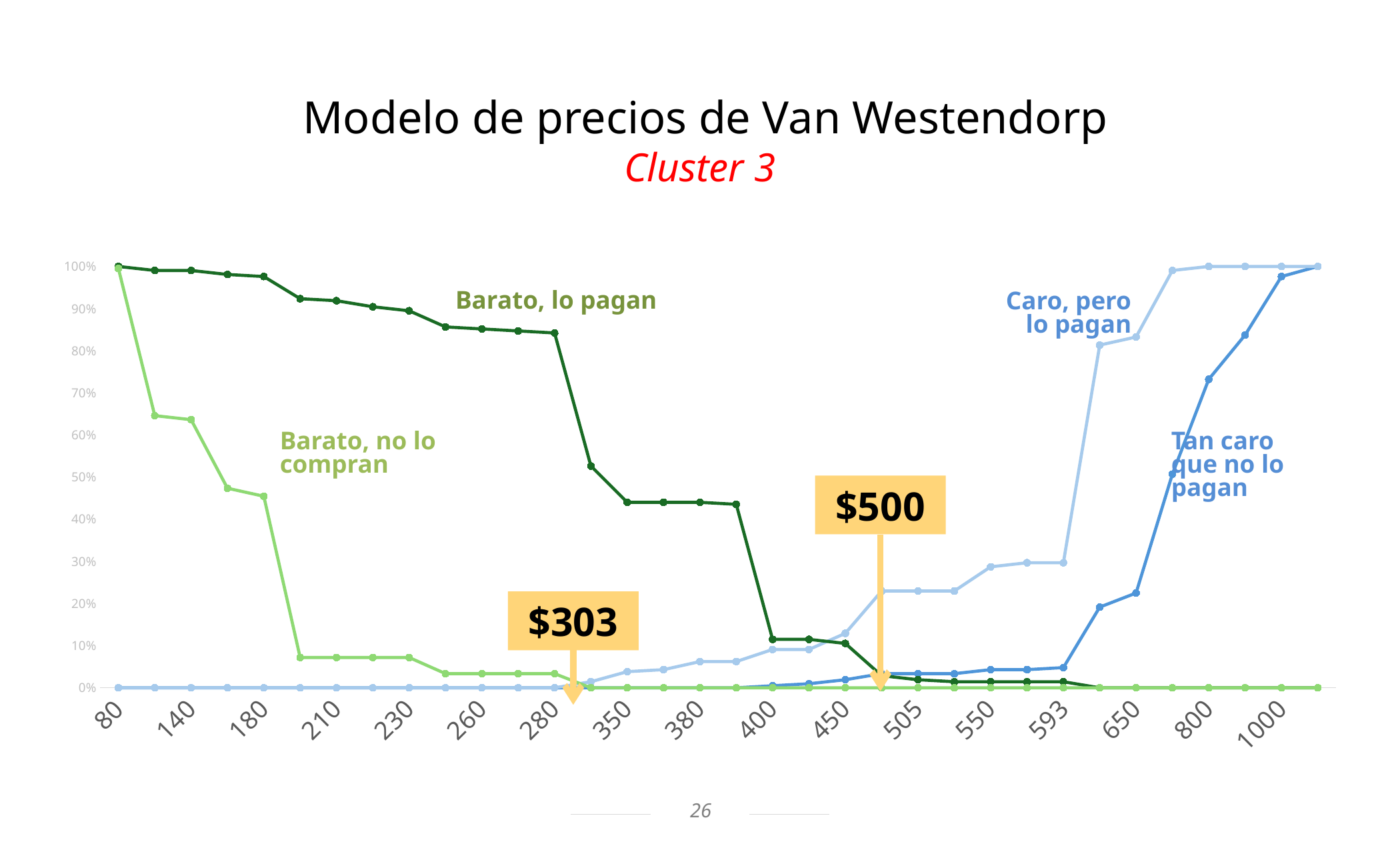
Does the 'Tan caro que no lo pagan' line rise or fall as the price increases along the x axis? rise How many data series are plotted on the chart? 4 Is the value of 'Caro, pero lo pagan' at 505 greater or less than 50%? less What two price points are highlighted with yellow callout boxes on the chart? $303 and $500 Is the value of 'Barato, lo pagan' at 400 greater or less than 30%? less How many price labels are shown on the x axis? 17 Is the value of 'Tan caro que no lo pagan' at 800 greater or less than 50%? greater At 650, which series has the higher value: 'Caro, pero lo pagan' or 'Tan caro que no lo pagan'? Caro, pero lo pagan What kind of chart is shown on the slide? line chart Does the 'Barato, lo pagan' line rise or fall as the price increases along the x axis? fall